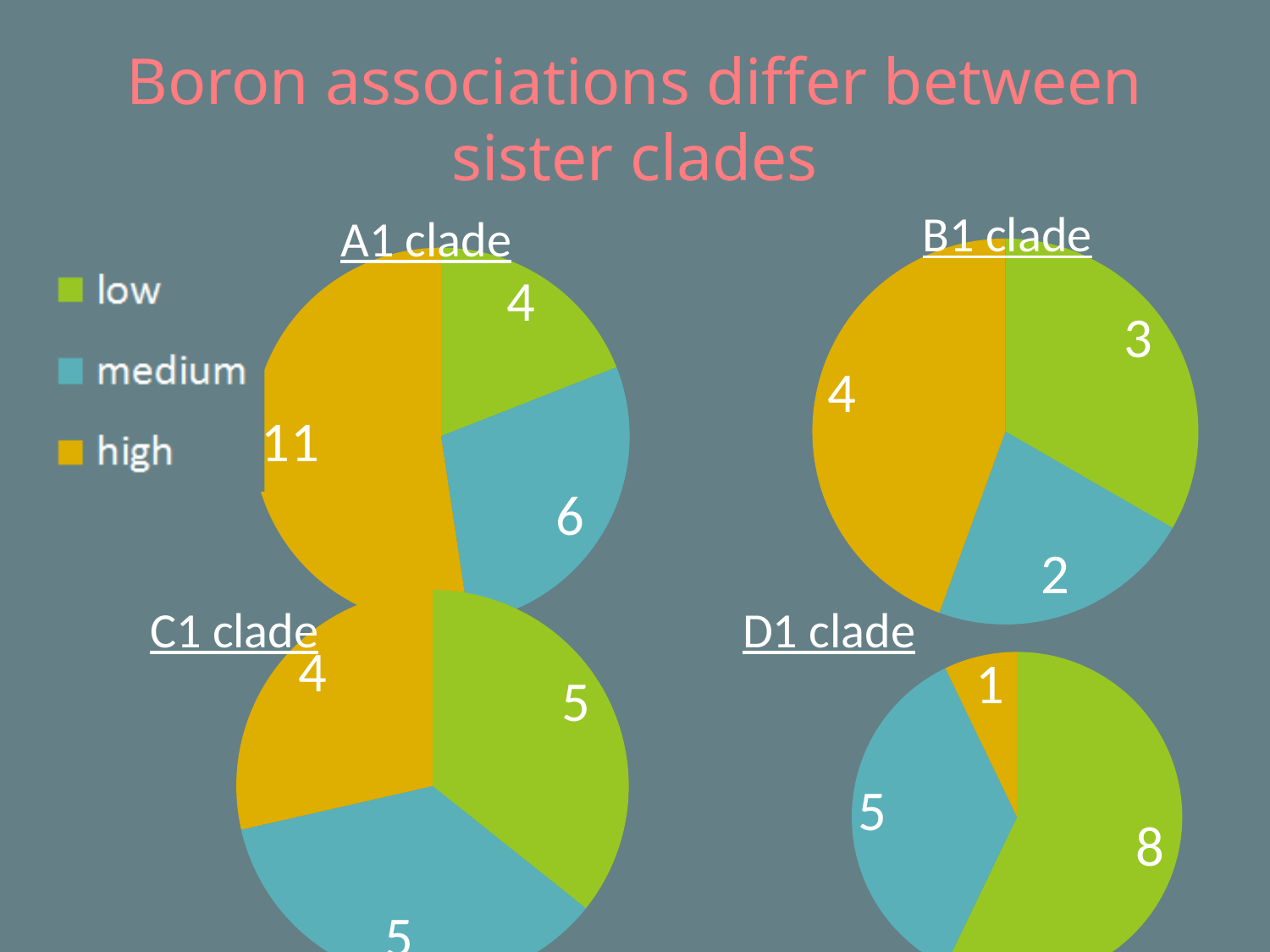
In the B1 clade pie chart, what is the value for the medium category? 2 In the A1 clade pie chart, which category has the largest slice? high In the D1 clade pie chart, which category has the smallest slice? high In the A1 clade pie chart, what is the difference between the high value and the low value? 7 In the D1 clade pie chart, what is the value for the low category? 8 In the B1 clade pie chart, what share of the total does the high slice represent? 4 out of 9 In the A1 clade pie chart, what is the value for the high category? 11 What is the total of all slices in the C1 clade pie chart? 14 In the B1 clade pie chart, which is larger, the low slice or the medium slice? low How many pie charts are shown on the slide? 4 What type of chart is used for the C1 clade? pie chart How many categories does the legend list? 3